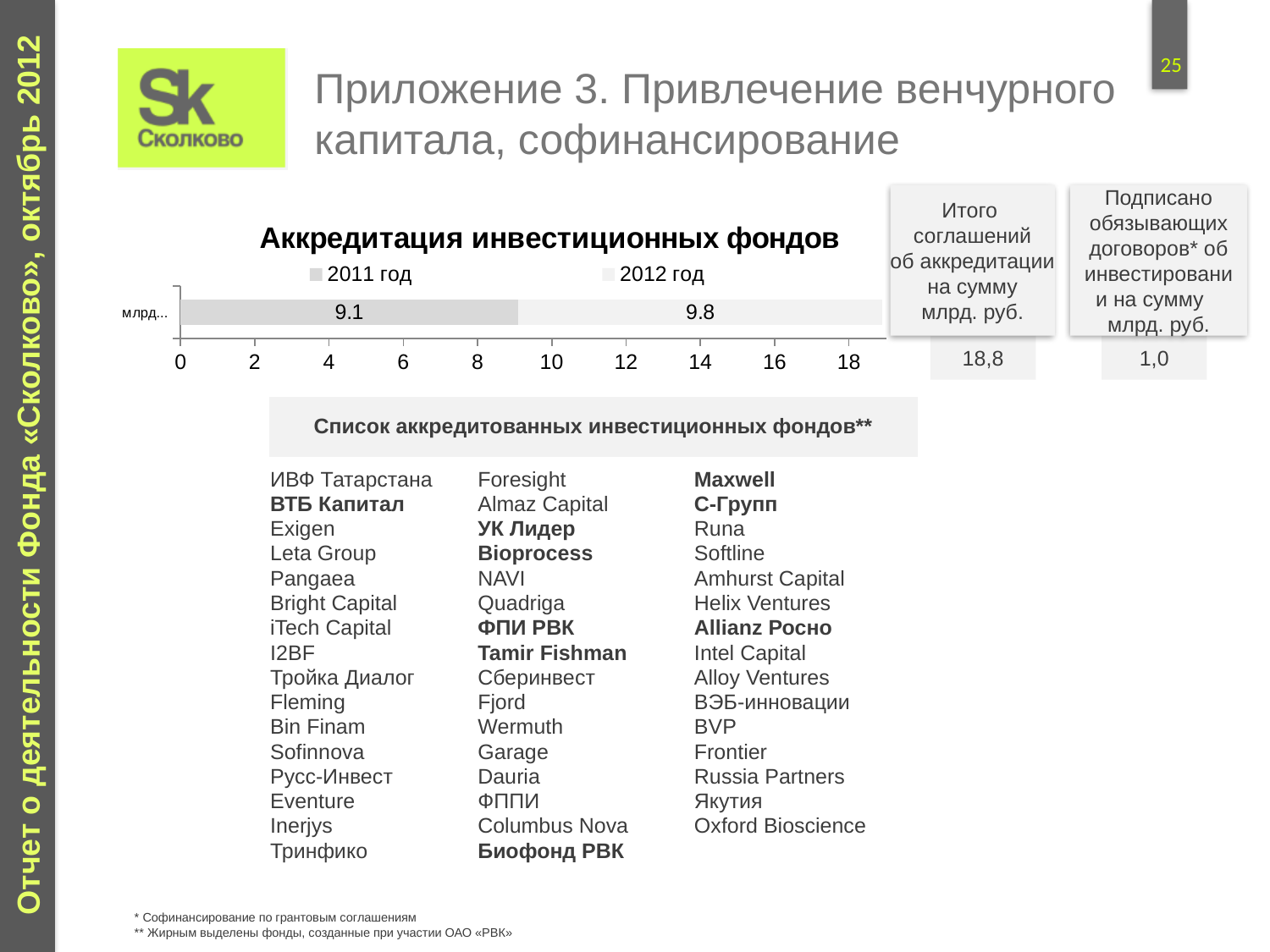
What is the highest tick value shown on the horizontal axis of the Аккредитация инвестиционных фондов chart? 18 How many series does the legend of the Аккредитация инвестиционных фондов chart list? 2 What is the value for the 2012 год series in the Аккредитация инвестиционных фондов chart? 9.8 How many bars (categories) are plotted in the Аккредитация инвестиционных фондов chart? 1 What is the value for the 2011 год series in the Аккредитация инвестиционных фондов chart? 9.1 Is the value for 2011 год in the Аккредитация инвестиционных фондов chart greater or less than 10? less Which series has the larger value in the Аккредитация инвестиционных фондов chart, 2011 год or 2012 год? 2012 год What kind of chart is the Аккредитация инвестиционных фондов chart? Stacked bar chart What is the total of the stacked bar in the Аккредитация инвестиционных фондов chart? 18.9 What are the two legend entries in the Аккредитация инвестиционных фондов chart? 2011 год and 2012 год What is the difference between the 2012 год and 2011 год values in the Аккредитация инвестиционных фондов chart? 0.7